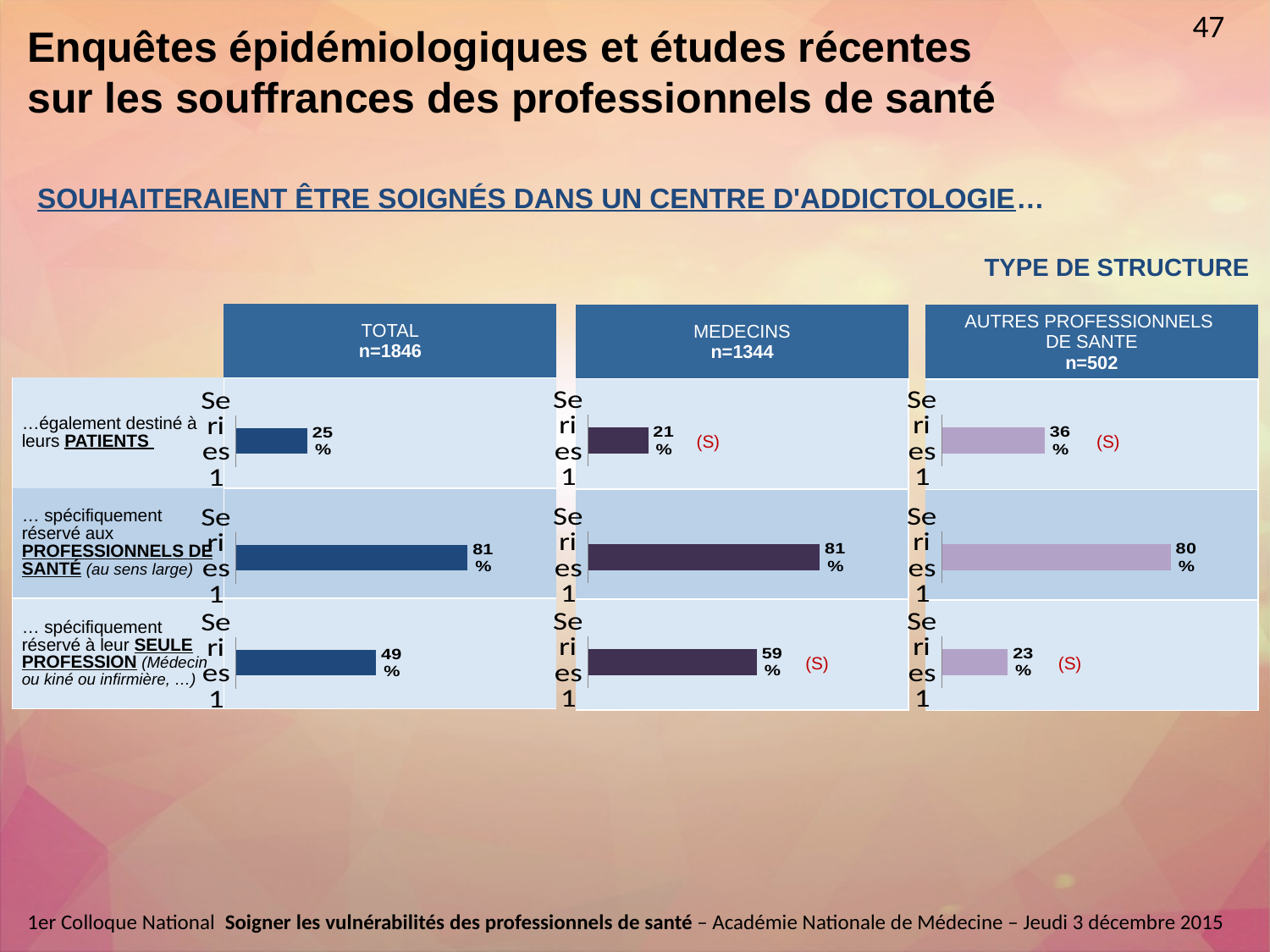
Across the three charts in the row '… spécifiquement réservé à leur SEULE PROFESSION', which column has the highest value? MEDECINS In the AUTRES PROFESSIONNELS DE SANTE column, what is the value for the bar in the row '…également destiné à leurs PATIENTS'? 36% In the MEDECINS column, what is the value for the bar in the row '… spécifiquement réservé à leur SEULE PROFESSION'? 59% How many columns of charts (types of structure) are shown on the slide? 3 What kind of chart is used in each cell of the grid? Bar chart In the TOTAL column, what is the value for the bar in the row '…également destiné à leurs PATIENTS'? 25% In the AUTRES PROFESSIONNELS DE SANTE column, what is the value for the bar in the row '… spécifiquement réservé aux PROFESSIONNELS DE SANTÉ'? 80% In the TOTAL column, which is larger: the value for '… spécifiquement réservé aux PROFESSIONNELS DE SANTÉ' or the value for '… spécifiquement réservé à leur SEULE PROFESSION'? … spécifiquement réservé aux PROFESSIONNELS DE SANTÉ In the MEDECINS column, what is the value for the bar in the row '…également destiné à leurs PATIENTS'? 21% What is the difference between the MEDECINS value (59%) and the AUTRES PROFESSIONNELS DE SANTE value (23%) in the row '… spécifiquement réservé à leur SEULE PROFESSION'? 36 percentage points Across the three charts in the row '…également destiné à leurs PATIENTS', which column has the lowest value? MEDECINS What is the sample size (n) shown for the MEDECINS column? n=1344